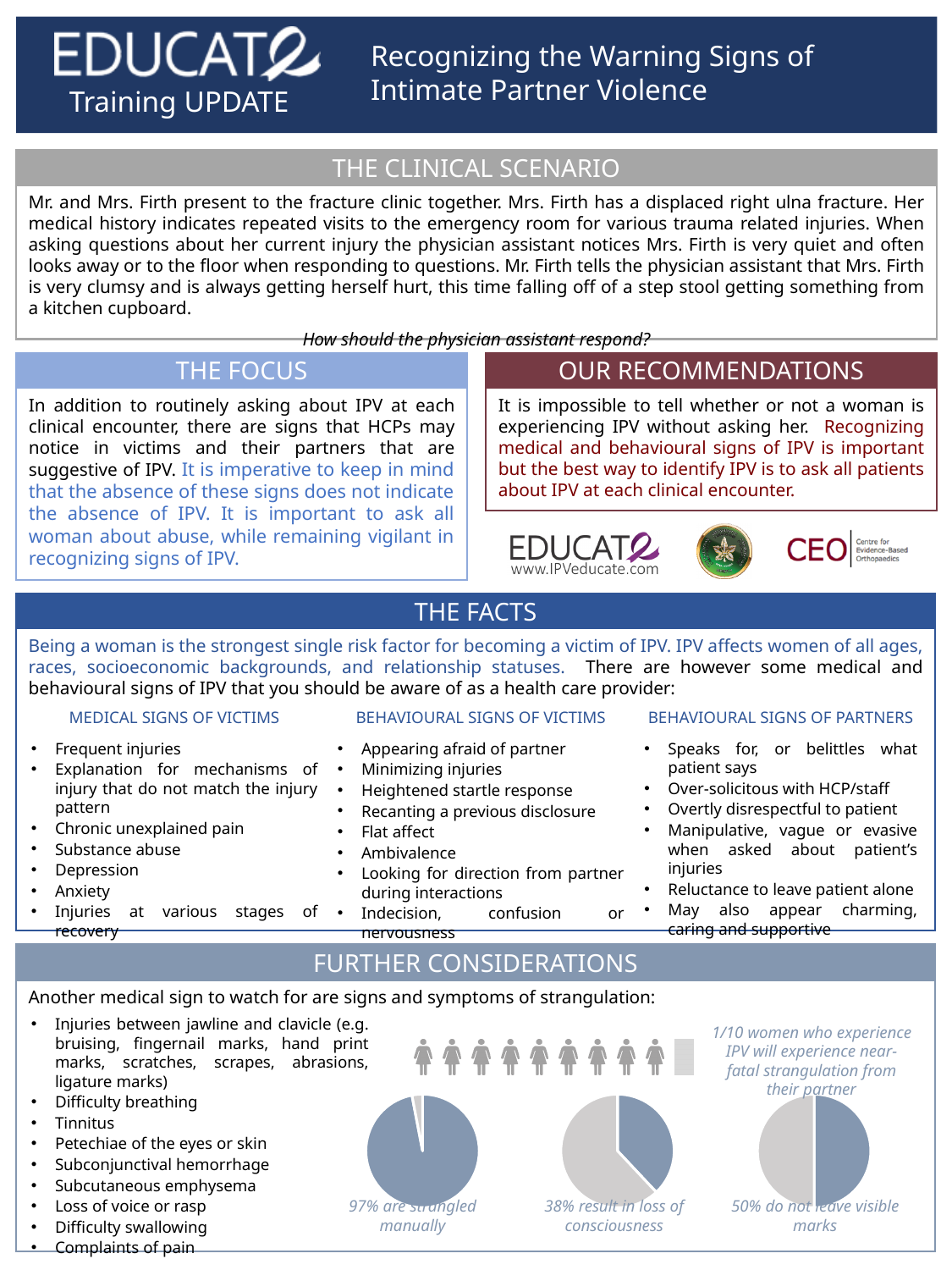
According to the right pie chart, what percentage do not leave visible marks? 50% According to the left pie chart, what percentage are strangled manually? 97% In the right pie chart, what share of the pie does the blue slice represent? 50% According to the pictogram of figures, what fraction of women who experience IPV will experience near-fatal strangulation from their partner? 1/10 How many pie charts are shown in the Further Considerations section? 3 Of the three pie charts, which statistic has the smallest highlighted share? 38% result in loss of consciousness In the left pie chart, what colour is the larger slice? blue What is the difference in percentage points between the share strangled manually and the share resulting in loss of consciousness? 59 Of the three pie charts, which statistic has the largest highlighted share? 97% are strangled manually According to the middle pie chart, what percentage result in loss of consciousness? 38% What kind of chart is used to show that 97% are strangled manually? pie chart Which is larger: the share strangled manually or the share resulting in loss of consciousness? strangled manually